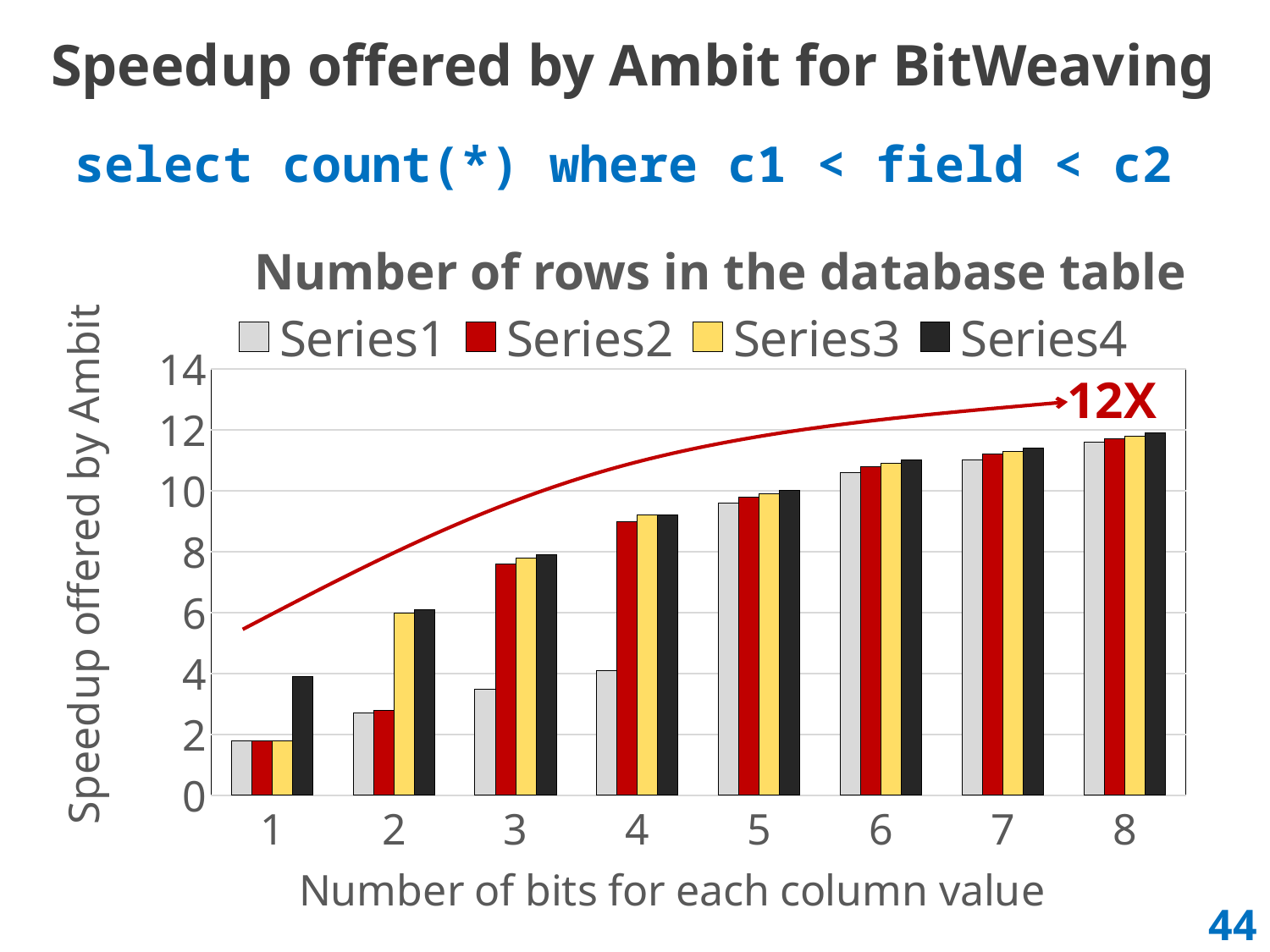
At 1 bit, which is larger: Series1 or Series4? Series4 At 2 bits, which is larger: Series1 or Series3? Series3 What is the label of the y axis? Speedup offered by Ambit How many series does the legend list? 4 What is the title shown above the chart legend? Number of rows in the database table Is the Series1 value at 6 bits greater or less than 10? greater Is the Series2 value at 3 bits greater or less than 8? less What kind of chart is shown on the slide? bar chart Which number of bits has the highest Series4 value? 8 Which number of bits has the lowest Series1 value? 1 How many categories (number of bits) are shown on the x axis? 8 Do the Series4 values rise or fall as the number of bits increases from 1 to 8? rise